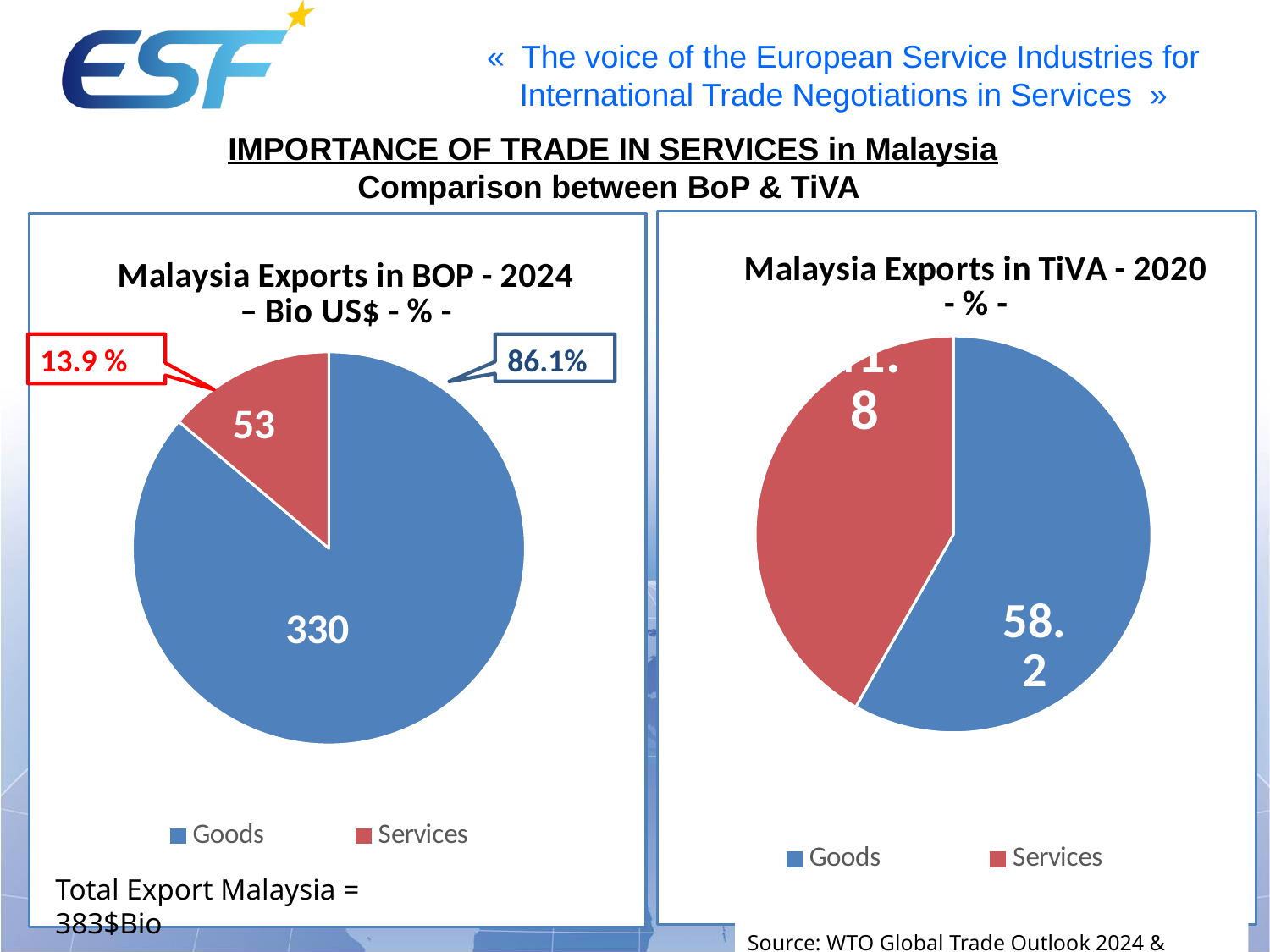
In the 'Malaysia Exports in BOP - 2024' chart, what is the value for Goods? 330 In the 'Malaysia Exports in BOP - 2024' chart, what is the value for Services? 53 How many categories does the legend of the 'Malaysia Exports in BOP - 2024' chart list? 2 In the 'Malaysia Exports in BOP - 2024' chart, which category is the smallest? Services In the 'Malaysia Exports in BOP - 2024' chart, what is the total of the Goods and Services values? 383 In the 'Malaysia Exports in BOP - 2024' chart, what percentage share do Goods have? 86.1% In the 'Malaysia Exports in TiVA - 2020' chart, what is the value for Goods? 58.2 In the 'Malaysia Exports in BOP - 2024' chart, what percentage share do Services have? 13.9 % In the 'Malaysia Exports in BOP - 2024' chart, what is the difference between the Goods and Services values? 277 In the 'Malaysia Exports in TiVA - 2020' chart, which category is larger, Goods or Services? Goods In the 'Malaysia Exports in TiVA - 2020' chart, what colour is the Services slice? Red What kind of chart is the 'Malaysia Exports in TiVA - 2020' chart? Pie chart